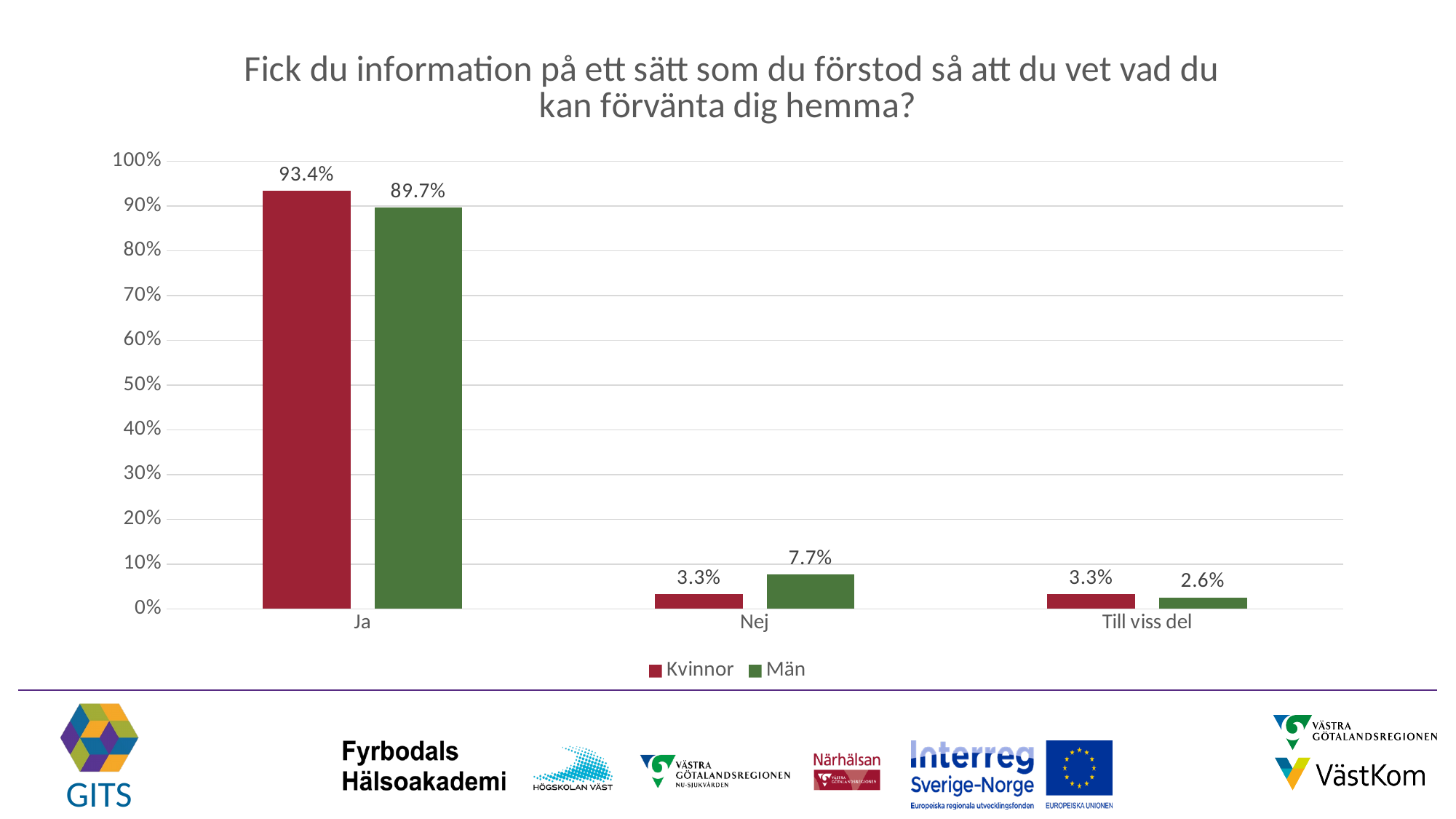
What is the difference between the Kvinnor and Män values for Ja? 3.7% What is the difference between the Män and Kvinnor values for Nej? 4.4% Which answer category has the highest value for Män? Ja What percentage of Män answered Nej? 7.7% For Nej, which series has the larger value, Kvinnor or Män? Män Is the value for Män at Ja greater or less than 80%? greater What percentage of Män answered Till viss del? 2.6% What kind of chart is shown on the slide? Bar chart How many answer categories are shown on the x axis? 3 What percentage of Kvinnor answered Ja? 93.4% Which answer category has the lowest value for Män? Till viss del How many series does the legend list? 2